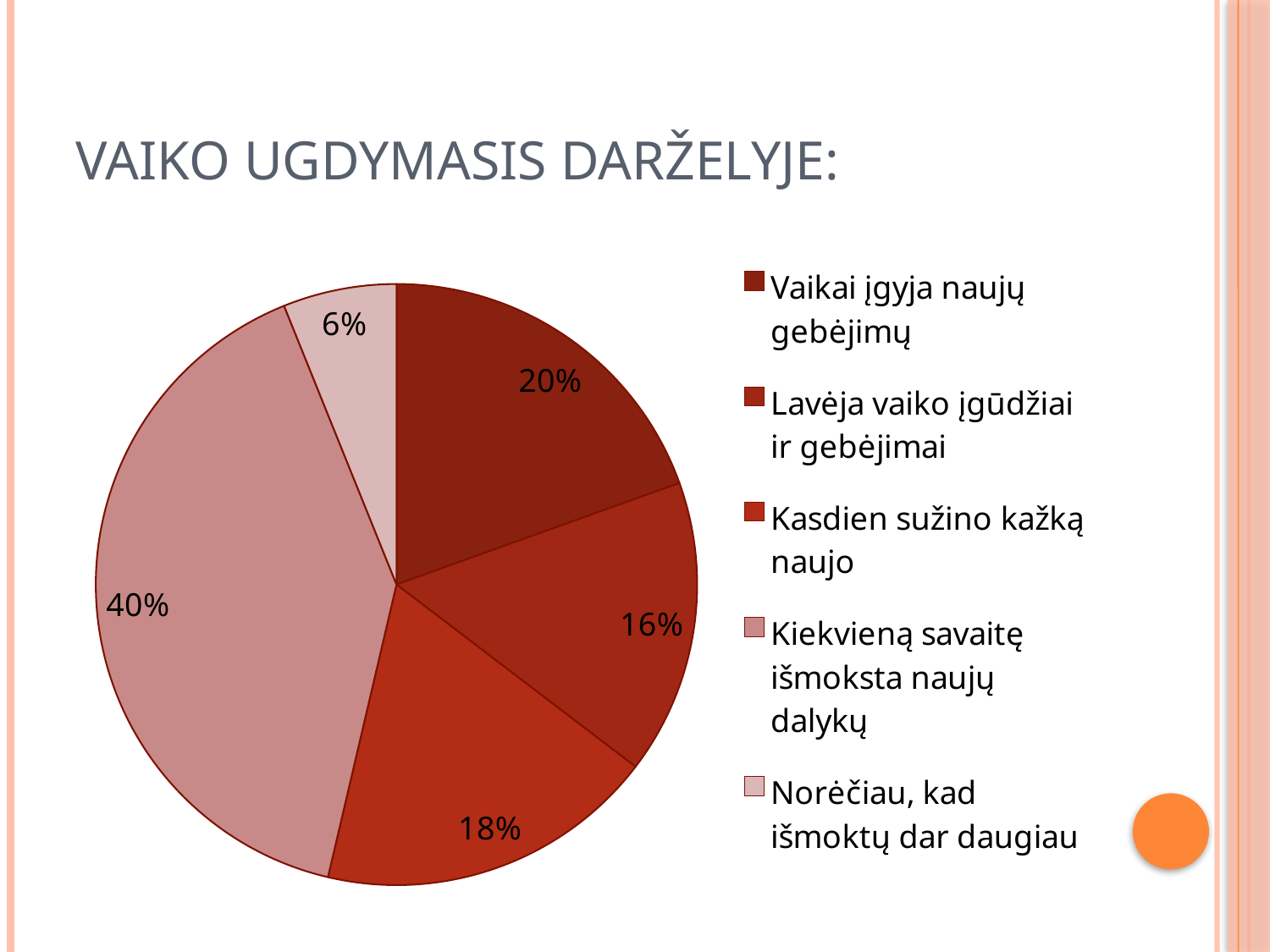
What is the difference in percentage points between "Kiekvieną savaitę išmoksta naujų dalykų" and "Vaikai įgyja naujų gebėjimų"? 20 What percentage is shown for "Kasdien sužino kažką naujo"? 18% What percentage is shown for "Norėčiau, kad išmoktų dar daugiau"? 6% How many slices does the pie chart have? 5 What type of chart is shown on the slide? pie chart What percentage is shown for "Lavėja vaiko įgūdžiai ir gebėjimai"? 16% Which is larger: the share for "Kasdien sužino kažką naujo" or for "Lavėja vaiko įgūdžiai ir gebėjimai"? Kasdien sužino kažką naujo Which category has the largest share of the pie? Kiekvieną savaitę išmoksta naujų dalykų What percentage is shown for "Kiekvieną savaitę išmoksta naujų dalykų"? 40% What is the title of the slide containing the chart? VAIKO UGDYMASIS DARŽELYJE: What percentage is shown for "Vaikai įgyja naujų gebėjimų"? 20% Which category has the smallest share of the pie? Norėčiau, kad išmoktų dar daugiau